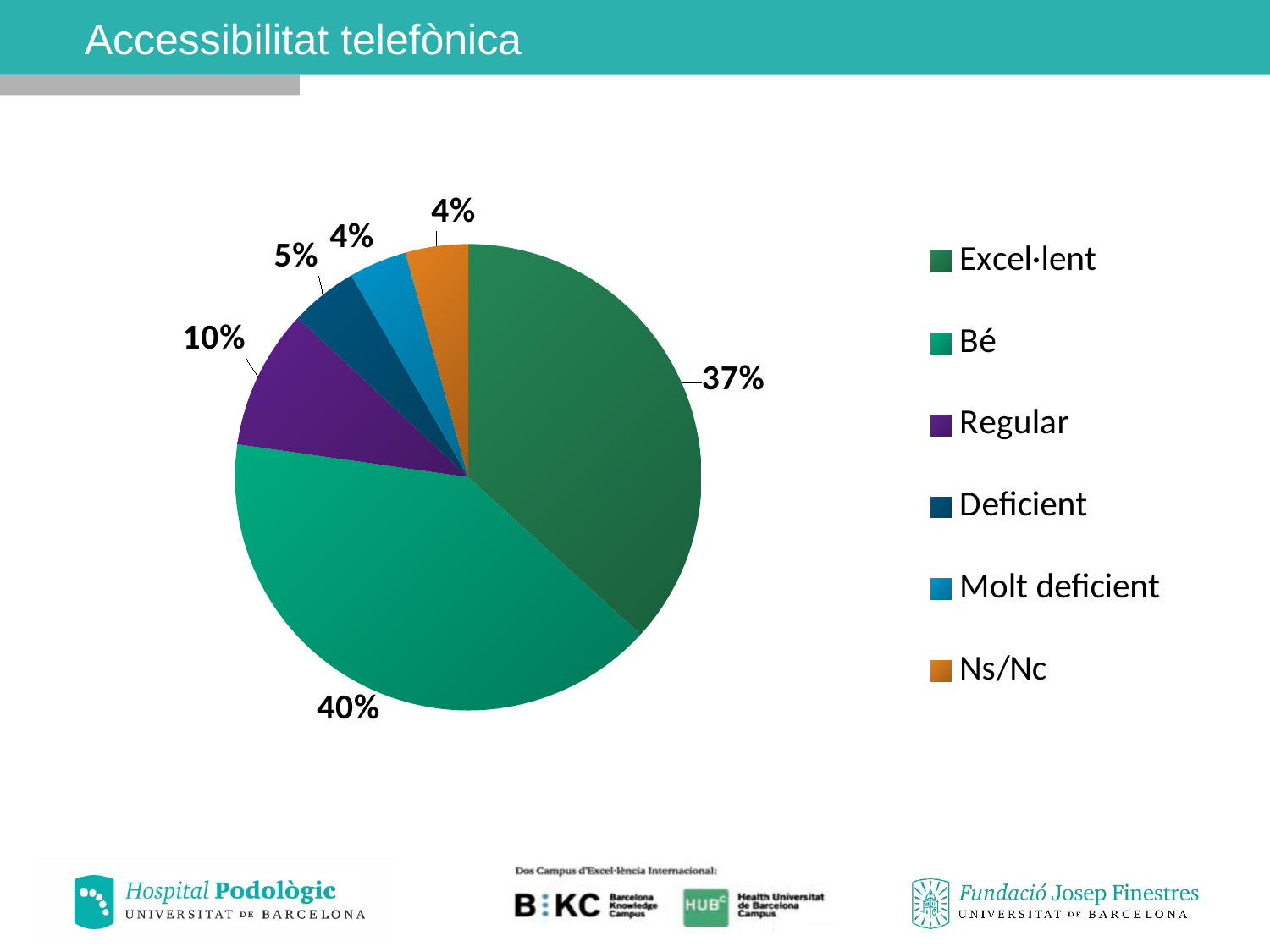
What is the difference in percentage points between Bé and Excel·lent? 3 What is the value for Regular? 10% Which is larger, the share for Excel·lent or the share for Bé? Bé Which category has the largest slice of the pie? Bé What is the title of the slide containing the chart? Accessibilitat telefònica What is the value for Ns/Nc? 4% What kind of chart is shown on the slide? Pie chart What percentage is labelled for Deficient? 5% How many categories does the pie chart show? 6 What share of the pie does Bé represent? 40% What share does Molt deficient have? 4% What percentage is shown for Excel·lent? 37%